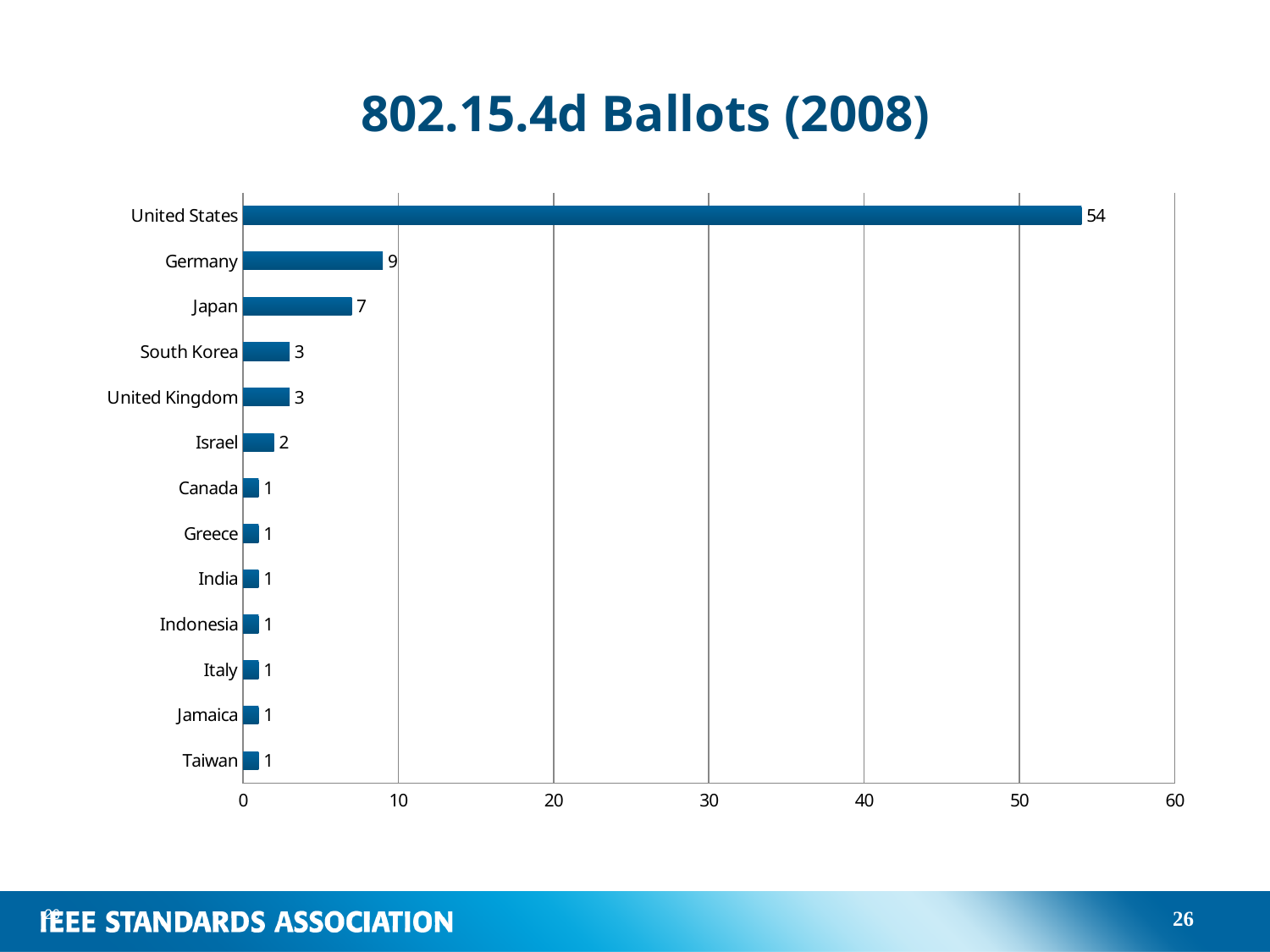
What is the value for Israel? 2 What is the difference between the values for United States and Germany? 45 Which category has the highest value? United States What is the value for Germany? 9 How many categories are shown in the chart? 13 What is the title of the chart? 802.15.4d Ballots (2008) Is the value for United States greater or less than 50? greater What is the difference between the values for Germany and Japan? 2 What kind of chart is shown on the slide? bar chart What is the value for United States? 54 What is the value for Japan? 7 Which is larger, the value for Japan or the value for South Korea? Japan